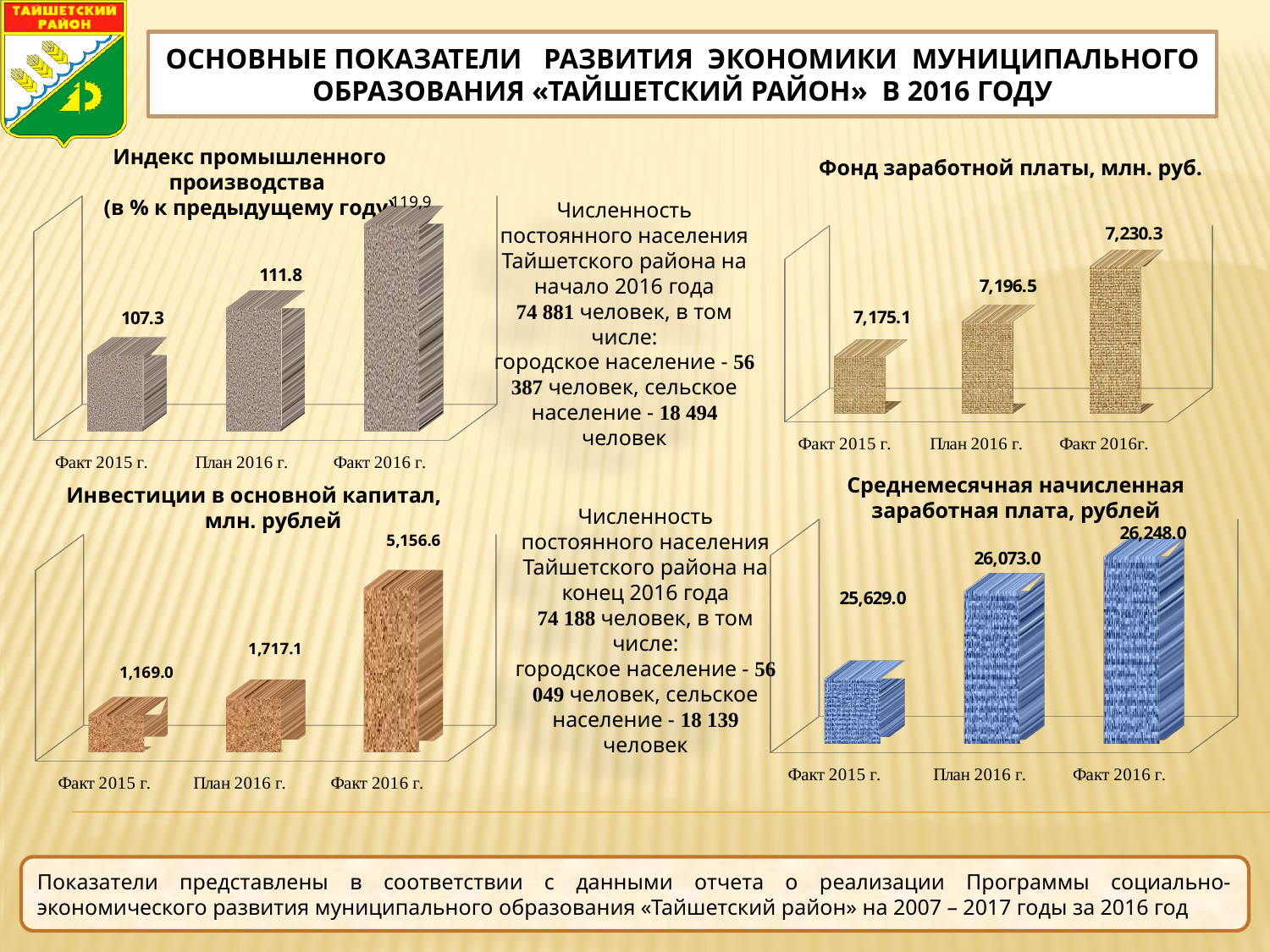
What kind of chart is the 'Среднемесячная начисленная заработная плата, рублей' chart? bar chart In the chart 'Среднемесячная начисленная заработная плата, рублей', do the values rise or fall from Факт 2015 г. to Факт 2016 г.? rise In the chart 'Индекс промышленного производства', what is the value for План 2016 г.? 111.8 In the chart 'Фонд заработной платы, млн. руб.', which category has the highest value? Факт 2016г. In the chart 'Инвестиции в основной капитал, млн. рублей', how many categories are shown? 3 In the chart 'Инвестиции в основной капитал, млн. рублей', what is the value for Факт 2016 г.? 5,156.6 In the chart 'Фонд заработной платы, млн. руб.', what is the value for Факт 2015 г.? 7,175.1 In the chart 'Среднемесячная начисленная заработная плата, рублей', what is the value for План 2016 г.? 26,073.0 In the chart 'Индекс промышленного производства', what is the difference between Факт 2016 г. and Факт 2015 г.? 12.6 In the chart 'Фонд заработной платы, млн. руб.', what is the difference between Факт 2016г. and Факт 2015 г.? 55.2 In the chart 'Инвестиции в основной капитал, млн. рублей', which category has the lowest value? Факт 2015 г. In the chart 'Индекс промышленного производства (в % к предыдущему году)', what is the value for Факт 2016 г.? 119,9